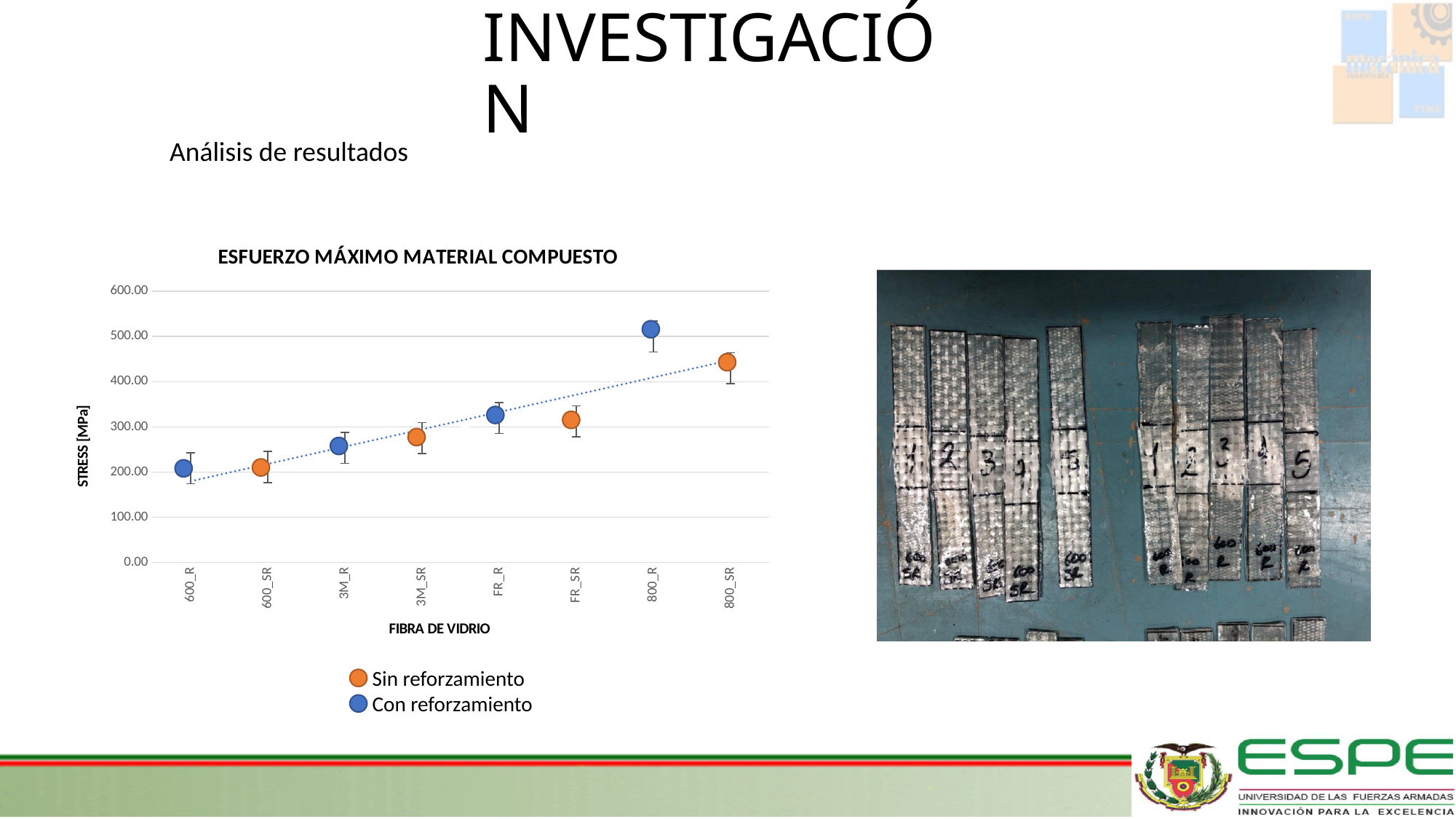
Which category has the highest stress value in the chart? 800_R What is the label of the y axis of the chart? STRESS [MPa] Is the value for 3M_R greater or less than 300? less How many series does the chart legend list? 2 Is the value for 600_R greater or less than 300? less What is the title of the chart? ESFUERZO MÁXIMO MATERIAL COMPUESTO Do the values generally rise or fall from left to right along the x axis? rise Which has the larger value, 800_R or 800_SR? 800_R Is the value for 800_SR greater or less than 400? greater What kind of chart is shown on the slide? scatter chart How many categories are shown on the x axis of the chart? 8